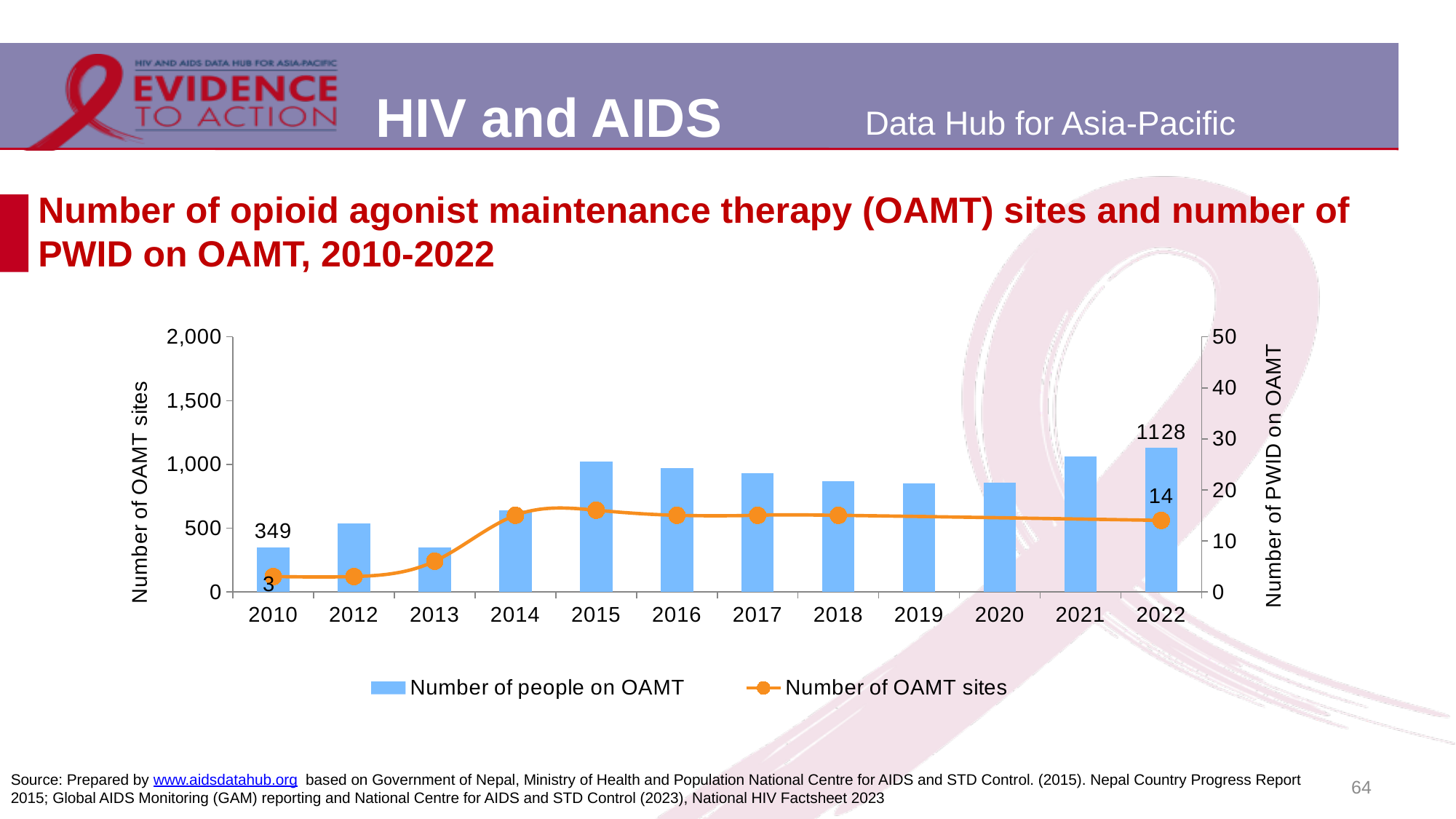
What kind of chart is this? Combination bar and line chart How many series does the legend list? 2 Is the number of people on OAMT in 2019 greater or less than 1,000? less By how much did the number of people on OAMT increase from 2010 to 2022? 779 In which year is the number of people on OAMT highest? 2022 What is the number of people on OAMT in 2010? 349 Which series is shown as an orange line with markers? Number of OAMT sites By how much did the number of OAMT sites increase from 2010 to 2022? 11 How many OAMT sites were there in 2022? 14 How many years are shown on the x axis? 12 How many OAMT sites were there in 2010? 3 What is the number of people on OAMT in 2022? 1128